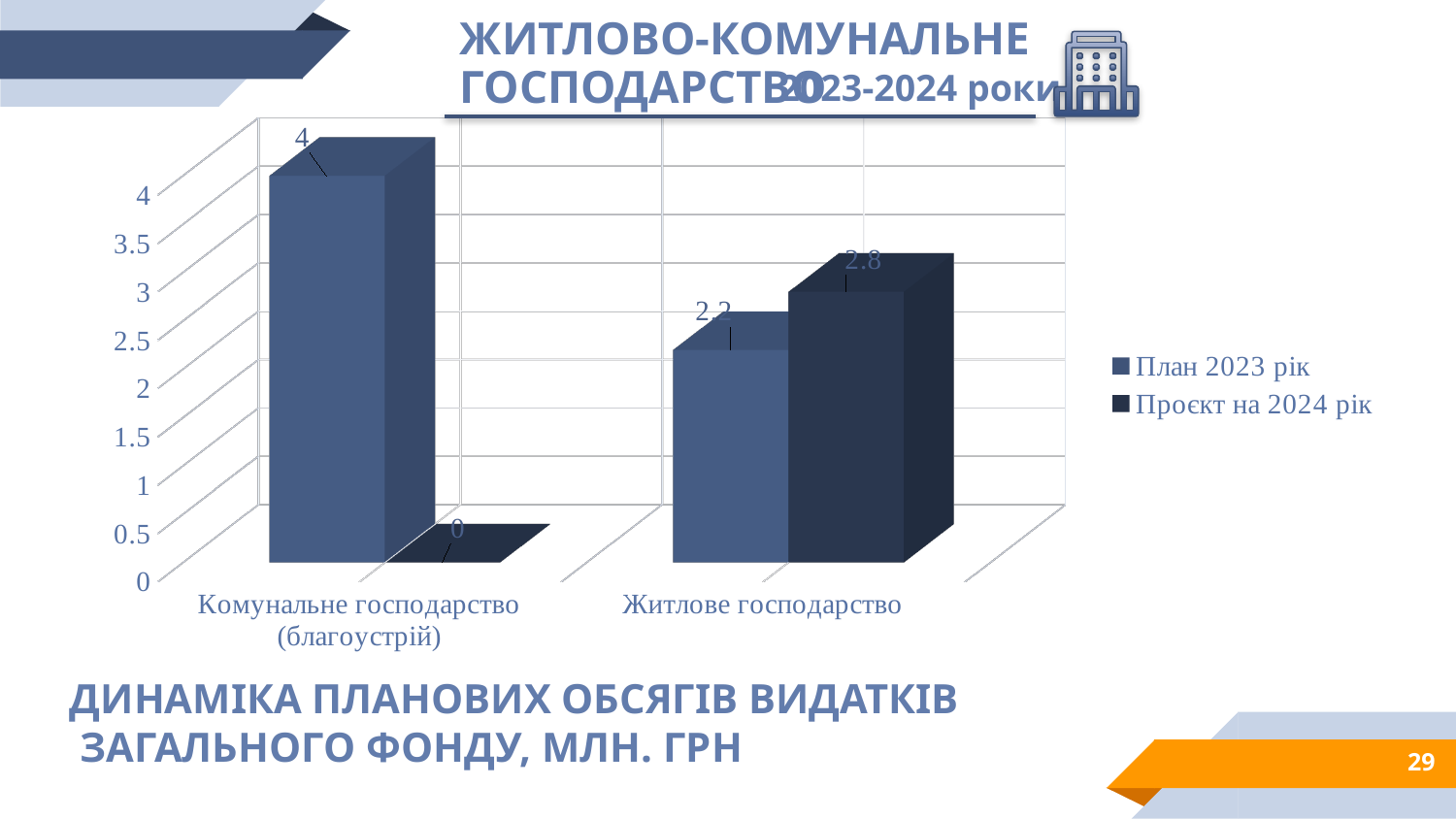
For "Житлове господарство", which is larger: "План 2023 рік" or "Проєкт на 2024 рік"? Проєкт на 2024 рік What is the value for "Проєкт на 2024 рік" in the category "Комунальне господарство (благоустрій)"? 0 How many series does the chart legend list? 2 What kind of chart is shown on the slide? Bar chart Which category has the lowest value for "Проєкт на 2024 рік"? Комунальне господарство (благоустрій) What is the value for "Проєкт на 2024 рік" in the category "Житлове господарство"? 2.8 How many categories are shown on the x axis of the chart? 2 What are the two series names listed in the chart legend? План 2023 рік; Проєкт на 2024 рік Which category has the highest value for "План 2023 рік"? Комунальне господарство (благоустрій) What is the value for "План 2023 рік" in the category "Комунальне господарство (благоустрій)"? 4 What is the value for "План 2023 рік" in the category "Житлове господарство"? 2.2 What is the difference between the "Проєкт на 2024 рік" and "План 2023 рік" values for "Житлове господарство"? 0.6